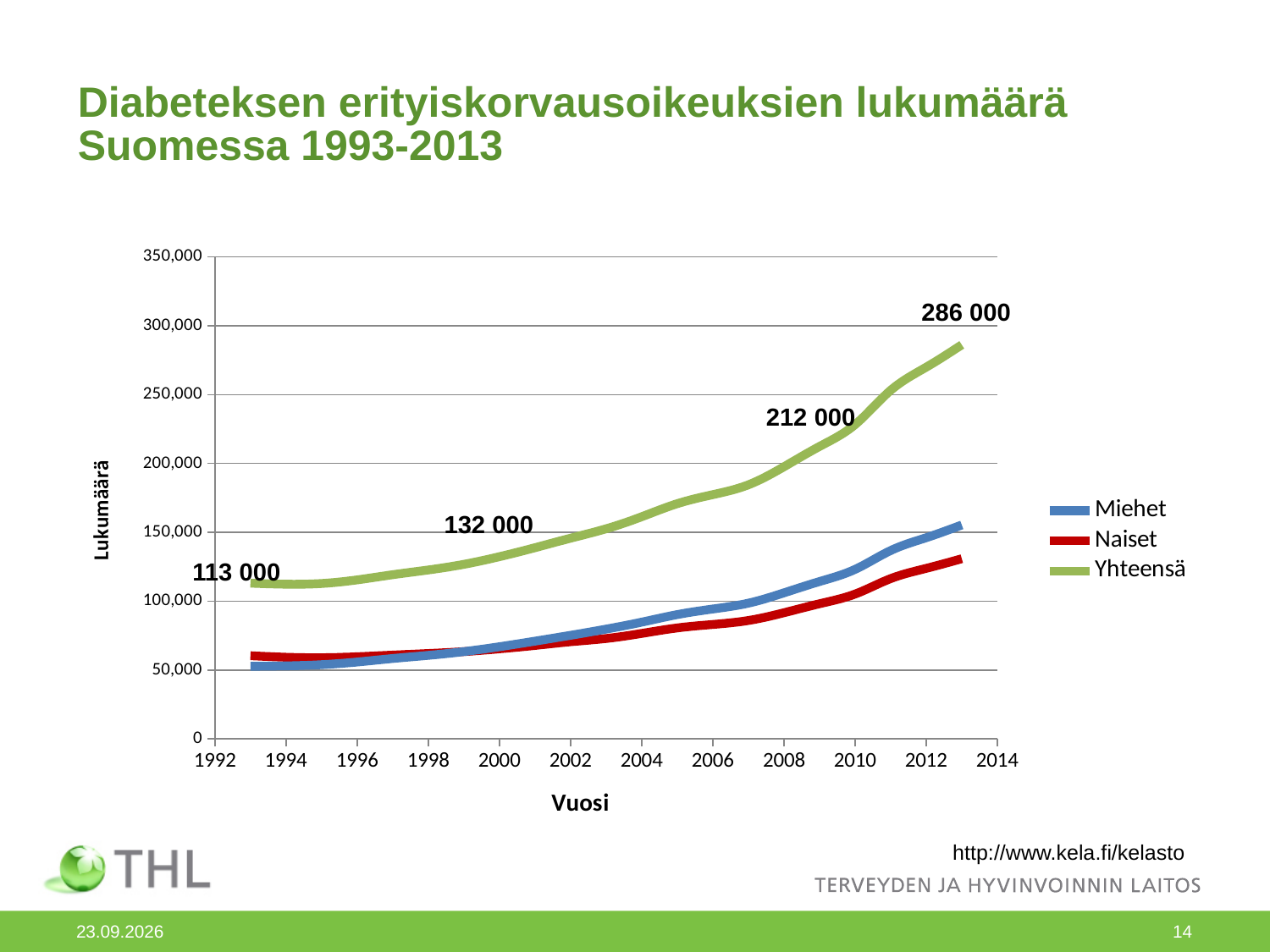
In 1993, which is larger, Miehet or Naiset? Naiset How many series does the legend list? 3 What is the value of Yhteensä in 1993? 113 000 By how much did Yhteensä increase from 1993 to 2013? 173 000 What is the title of the x axis? Vuosi Which series has the highest value in 2013? Yhteensä What type of chart is shown on the slide? line chart Which series has the lowest value in 2013? Naiset What is the value of Yhteensä in 2013? 286 000 Does the Yhteensä line rise or fall from 1993 to 2013? rise Is the value for Miehet in 2013 greater or less than 150,000? greater In 2013, which is larger, Miehet or Naiset? Miehet